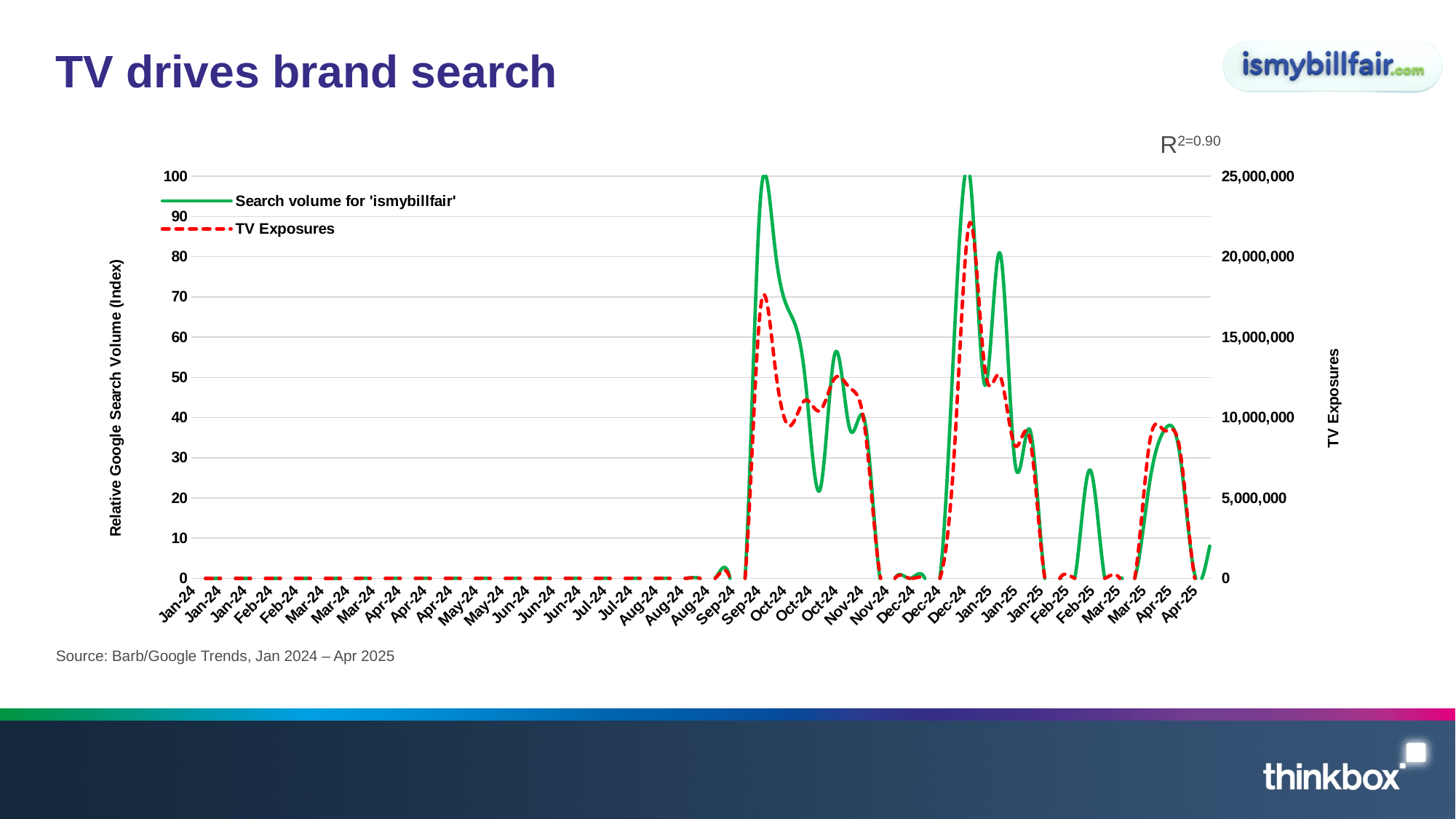
What is the peak value reached by the search volume index line? 100 Is the search volume index peak in Feb-25 greater or less than 30? less Is the peak of TV Exposures around Dec-24 greater or less than 20,000,000? greater Is the peak of TV Exposures around Sep-24/Oct-24 greater or less than 15,000,000? greater What kind of chart is shown on the slide? Line chart What R-squared value is shown on the chart? R2=0.90 How many series does the legend list? 2 Which is higher: the search volume index peak in Dec-24 or the peak in Feb-25? Dec-24 Which series is drawn as a red dashed line? TV Exposures How do the search volume and TV Exposures lines behave from Jan-24 to Aug-24? Flat near zero